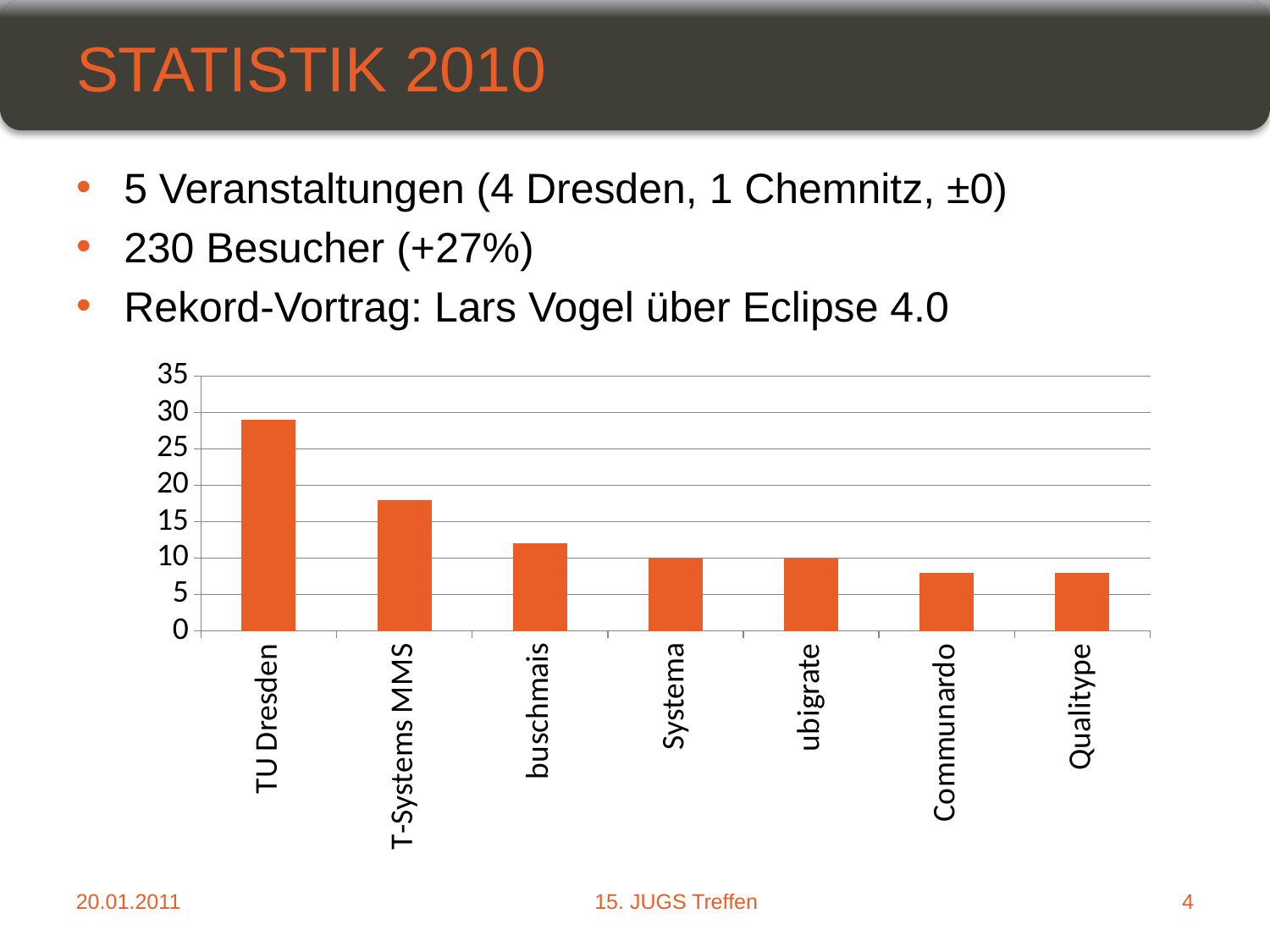
Which category has the highest bar in the chart? TU Dresden Which is larger, the value for TU Dresden or the value for T-Systems MMS? TU Dresden What colour are the bars in the chart? orange How many categories are shown on the x axis of the chart? 7 Is the value for T-Systems MMS greater or less than 15? greater Do the bar values rise or fall from left to right along the x axis? fall Is the value for Communardo greater or less than 10? less Is the value for T-Systems MMS greater or less than 20? less What kind of chart is shown on the slide? bar chart